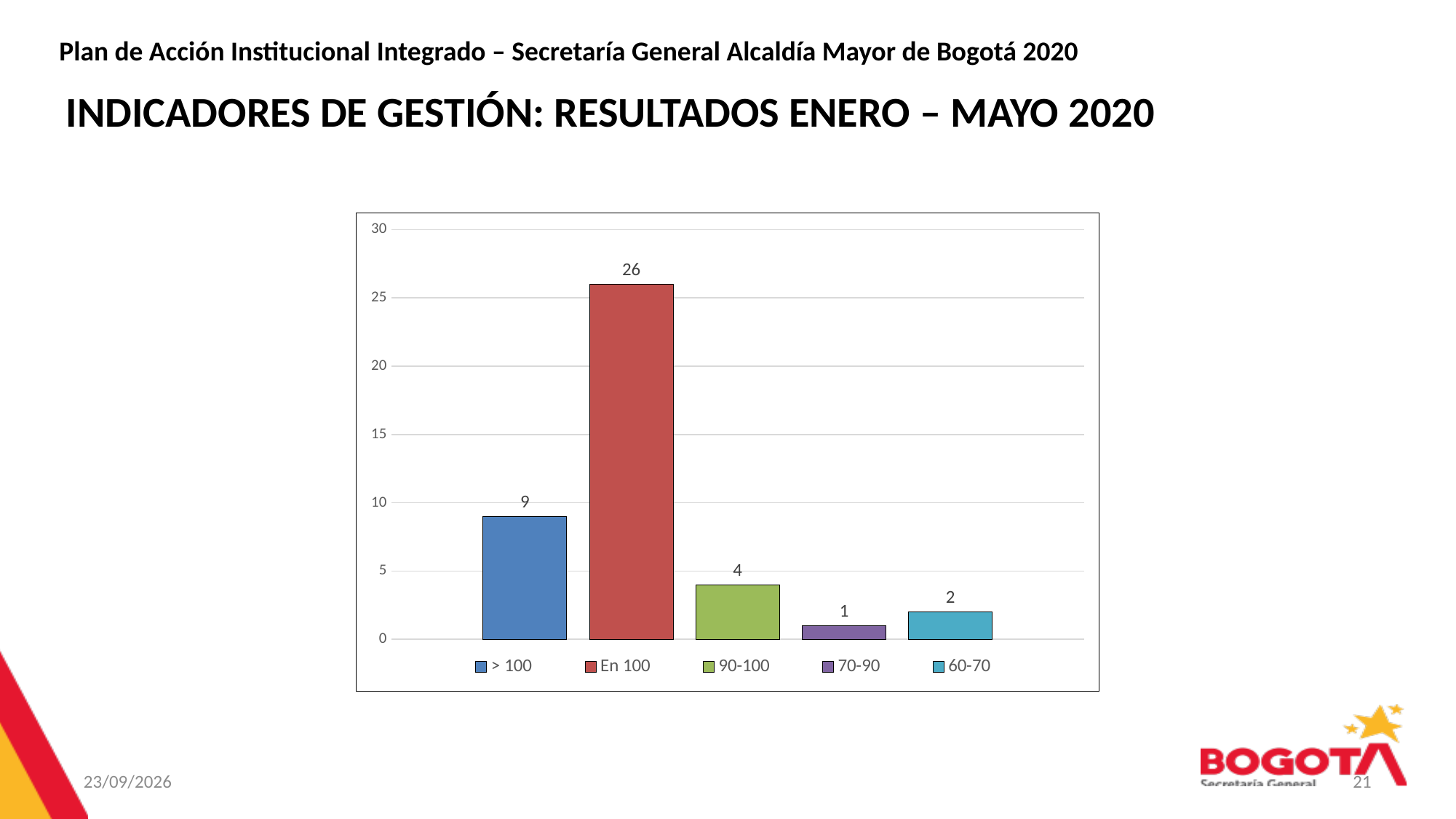
What kind of chart is shown on the slide? Bar chart How many categories are shown in the chart? 5 What colour is the bar for the "En 100" category? Red Which category has the lowest value? 70-90 What is the difference between the values for "En 100" and "> 100"? 17 What is the value for the "90-100" category? 4 What is the value for the "En 100" category? 26 Which is larger, the value for "90-100" or the value for "60-70"? 90-100 What is the value for the "> 100" category? 9 Which category has the highest value? En 100 What is the value for the "70-90" category? 1 What is the value for the "60-70" category? 2